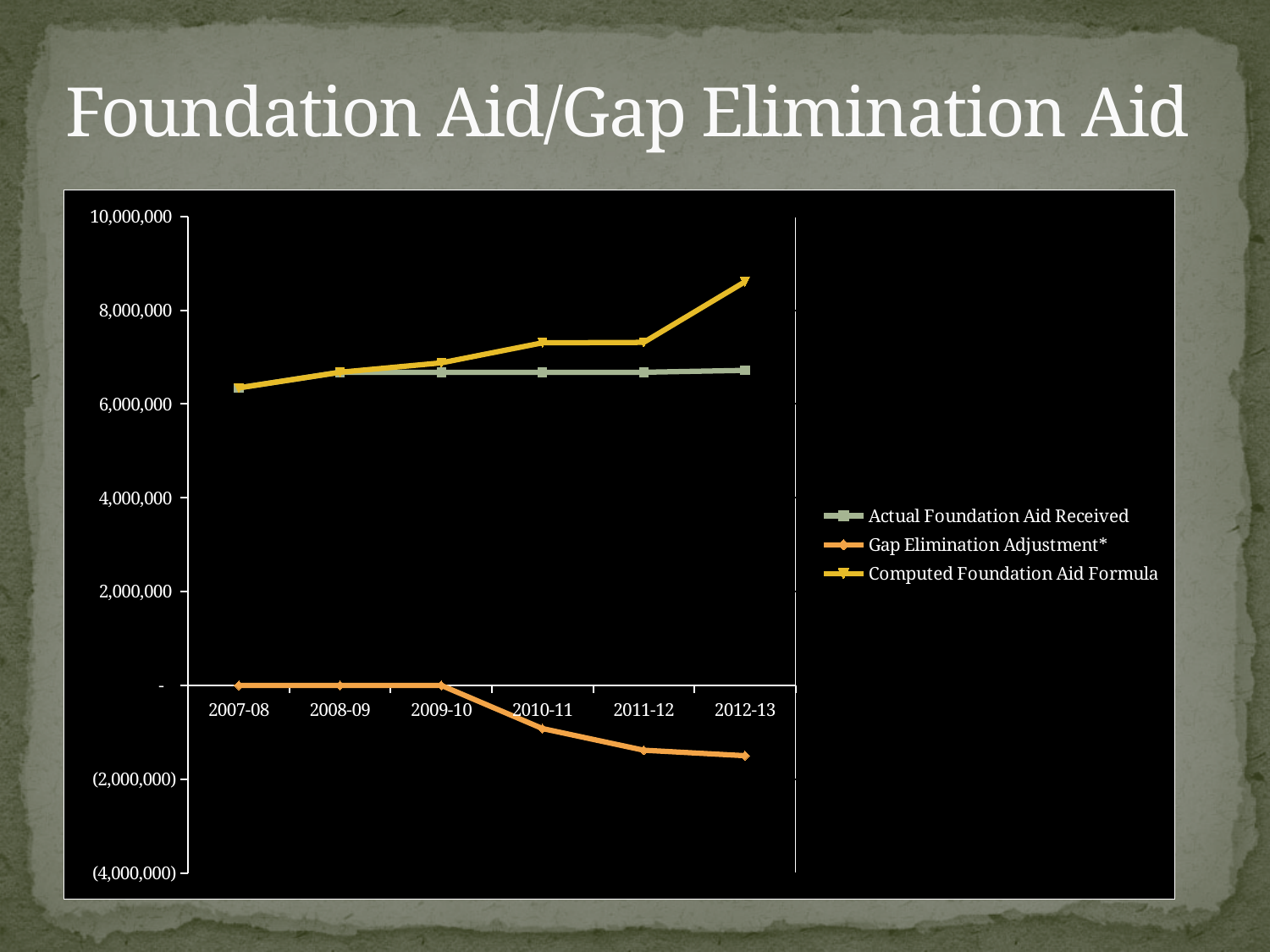
How many school years are shown on the x axis? 6 What kind of chart is shown on the slide? line chart Is the Gap Elimination Adjustment* value for 2011-12 greater or less than 0? less Is the Actual Foundation Aid Received value for 2012-13 greater or less than 8,000,000? less Is the Computed Foundation Aid Formula value for 2007-08 greater or less than 6,000,000? greater In which year is the Computed Foundation Aid Formula value highest? 2012-13 Does the Gap Elimination Adjustment* line rise or fall from 2009-10 to 2012-13? fall In 2012-13, which is larger: Computed Foundation Aid Formula or Actual Foundation Aid Received? Computed Foundation Aid Formula What is the title of the slide containing the chart? Foundation Aid/Gap Elimination Aid How many series does the legend list? 3 Does the Computed Foundation Aid Formula line rise or fall from 2007-08 to 2012-13? rise